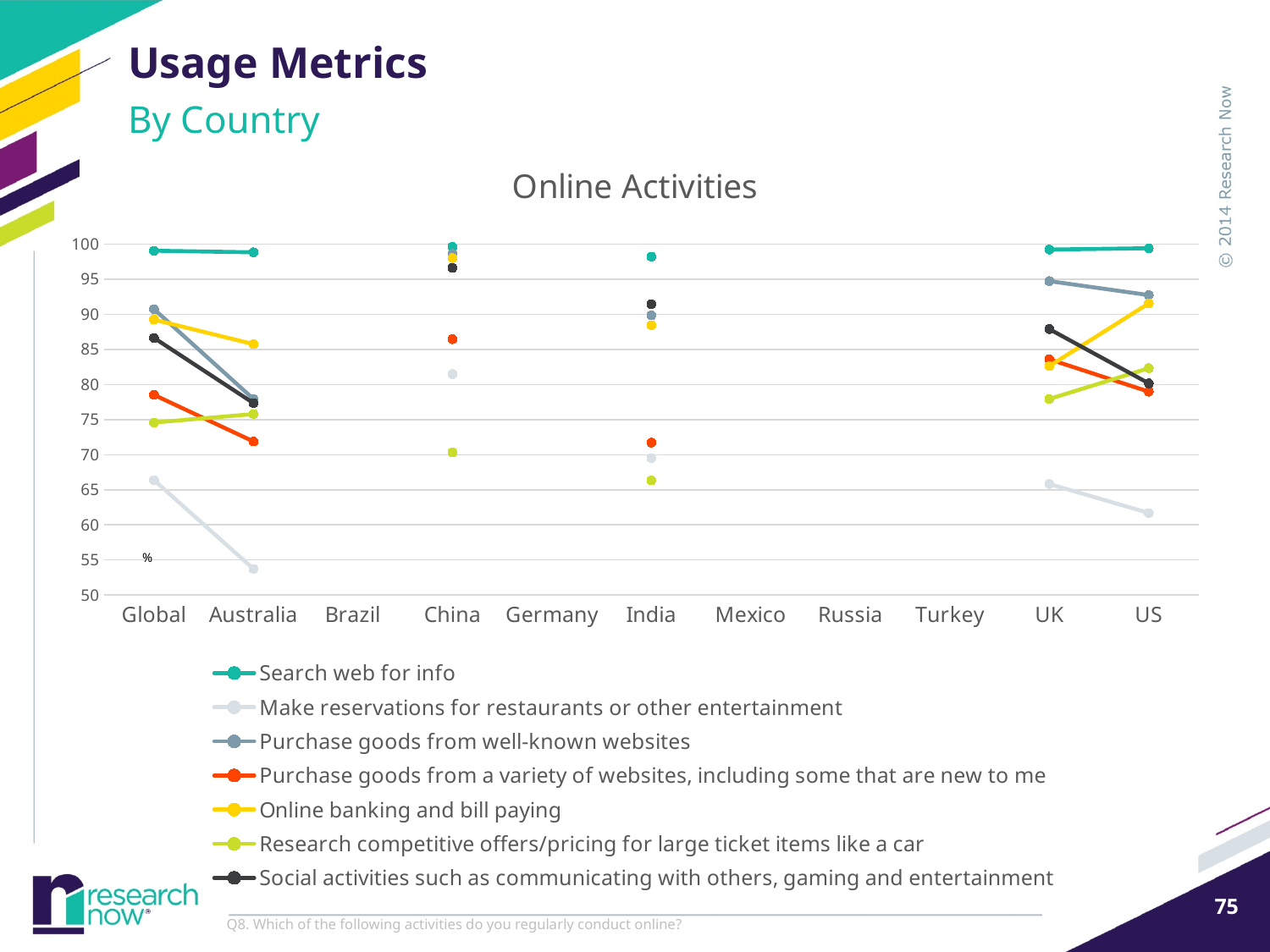
Which series has the lowest value for Global? Make reservations for restaurants or other entertainment Is the value for 'Make reservations for restaurants or other entertainment' for Australia greater or less than 60? less How many series does the legend list? 7 What is the title of the chart? Online Activities Which series has the highest value for China? Search web for info Is the value for 'Research competitive offers/pricing for large ticket items like a car' for China greater or less than 75? less Does the value for 'Make reservations for restaurants or other entertainment' rise or fall from UK to US? Fall For US, which is higher: 'Online banking and bill paying' or 'Purchase goods from a variety of websites, including some that are new to me'? Online banking and bill paying Is the value for 'Social activities such as communicating with others, gaming and entertainment' for UK greater or less than 85? greater How many countries (including Global) are listed along the x axis? 11 What kind of chart is shown on the slide? Line chart